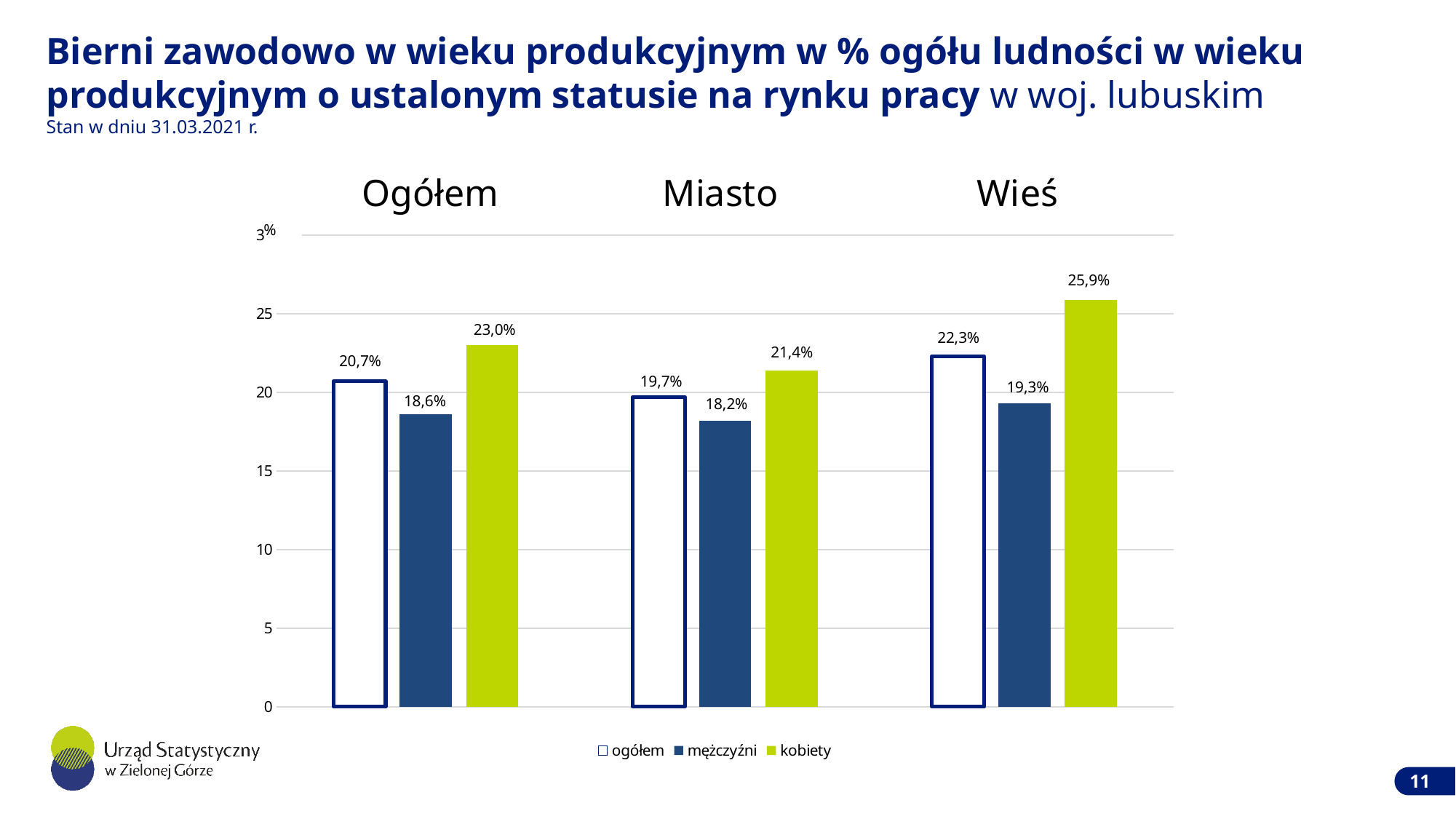
Which group has the highest value for kobiety? Wieś What is the difference between the ogółem values for Wieś and Miasto? 2,6 percentage points Which group has the lowest value for mężczyźni? Miasto What is the value for kobiety in the Wieś group? 25,9% What is the value for ogółem in the Ogółem group? 20,7% What is the difference between the kobiety and mężczyźni values in the Wieś group? 6,6 percentage points How many groups of bars are shown on the chart? 3 Which is larger: the kobiety value for Ogółem or the kobiety value for Miasto? Ogółem How many series does the legend list? 3 What is the value for mężczyźni in the Miasto group? 18,2% Is the value for mężczyźni in the Wieś group greater or less than 20? less What kind of chart is shown on the slide? bar chart